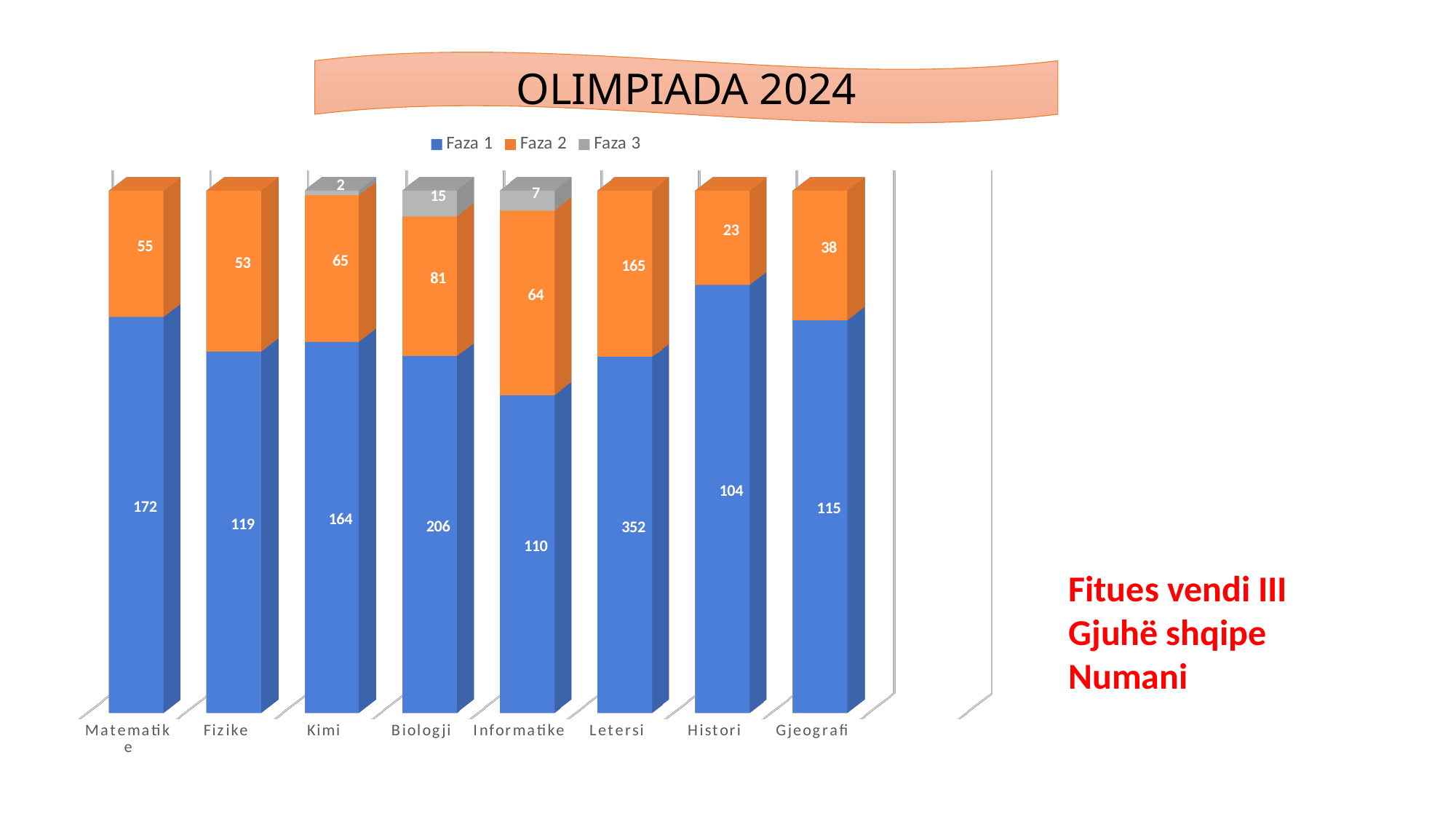
What is the difference between the Faza 1 values for Biologji and Matematike? 34 Which category has the highest Faza 1 value? Letersi What kind of chart is shown on the slide? Stacked bar chart What is the total of the stacked bar for Biologji? 302 How many categories are shown on the x axis? 8 What is the Faza 3 value for Informatike? 7 Which is larger, the Faza 2 value for Kimi or the Faza 2 value for Gjeografi? Kimi Which category has the lowest Faza 2 value? Histori What is the Faza 1 value for Letersi? 352 How many series does the legend list? 3 What is the title shown above the chart? OLIMPIADA 2024 What is the Faza 2 value for Biologji? 81